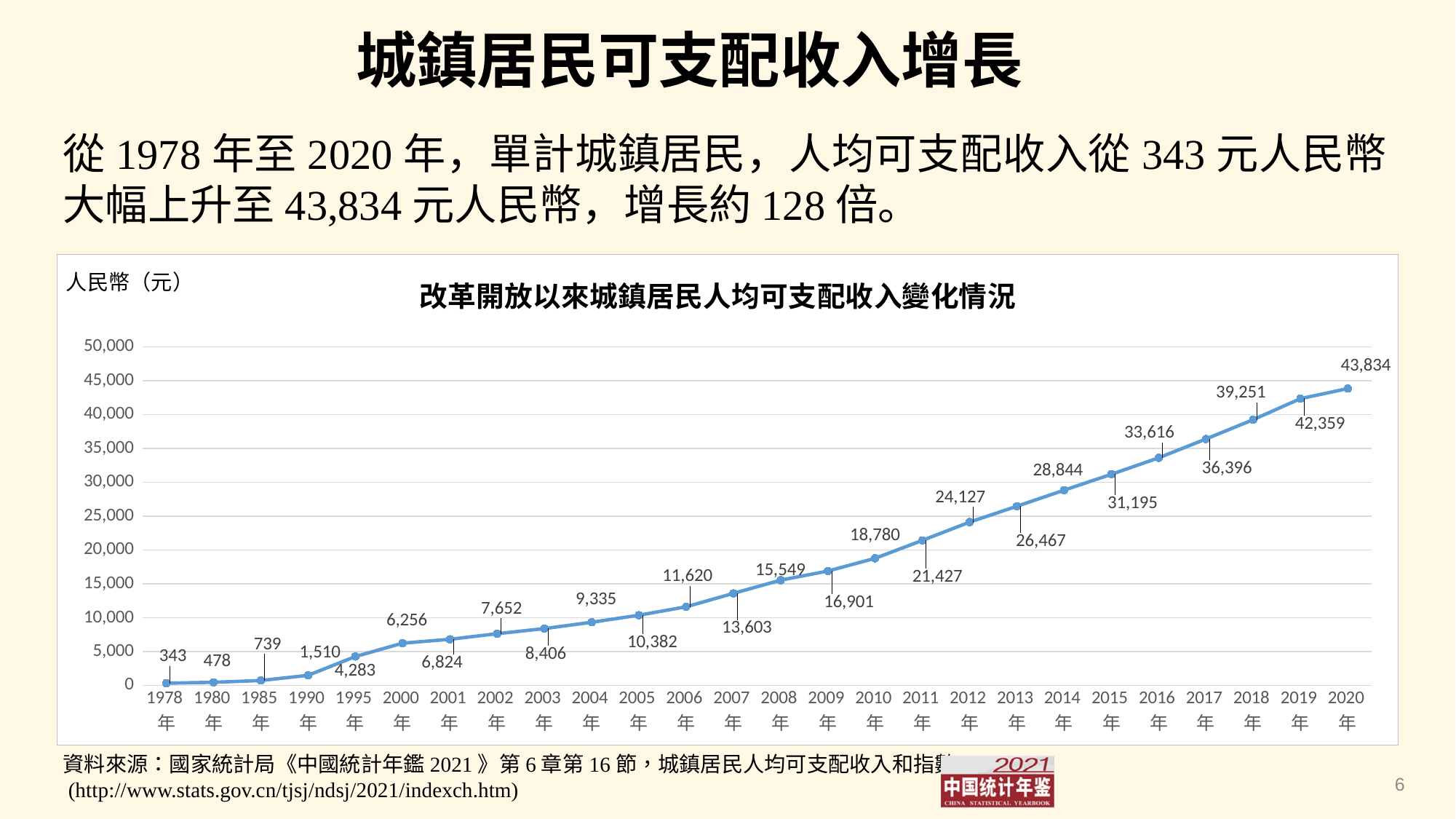
Which is larger, the value for 2008 年 or the value for 2009 年? 2009 年 What is the value for 2010 年 in the chart? 18,780 What is the value for 2016 年 in the chart? 33,616 What is the value for 1995 年 in the chart? 4,283 What is the title of the chart? 改革開放以來城鎮居民人均可支配收入變化情況 Which year has the lowest value in the chart? 1978 年 How many data points are plotted in the chart? 26 Is the value for 2013 年 greater or less than 25,000? greater Which year has the highest value in the chart? 2020 年 What is the difference between the values for 2010 年 and 2000 年? 12,524 What kind of chart is shown on the slide? line chart What is the difference between the values for 2020 年 and 2019 年? 1,475